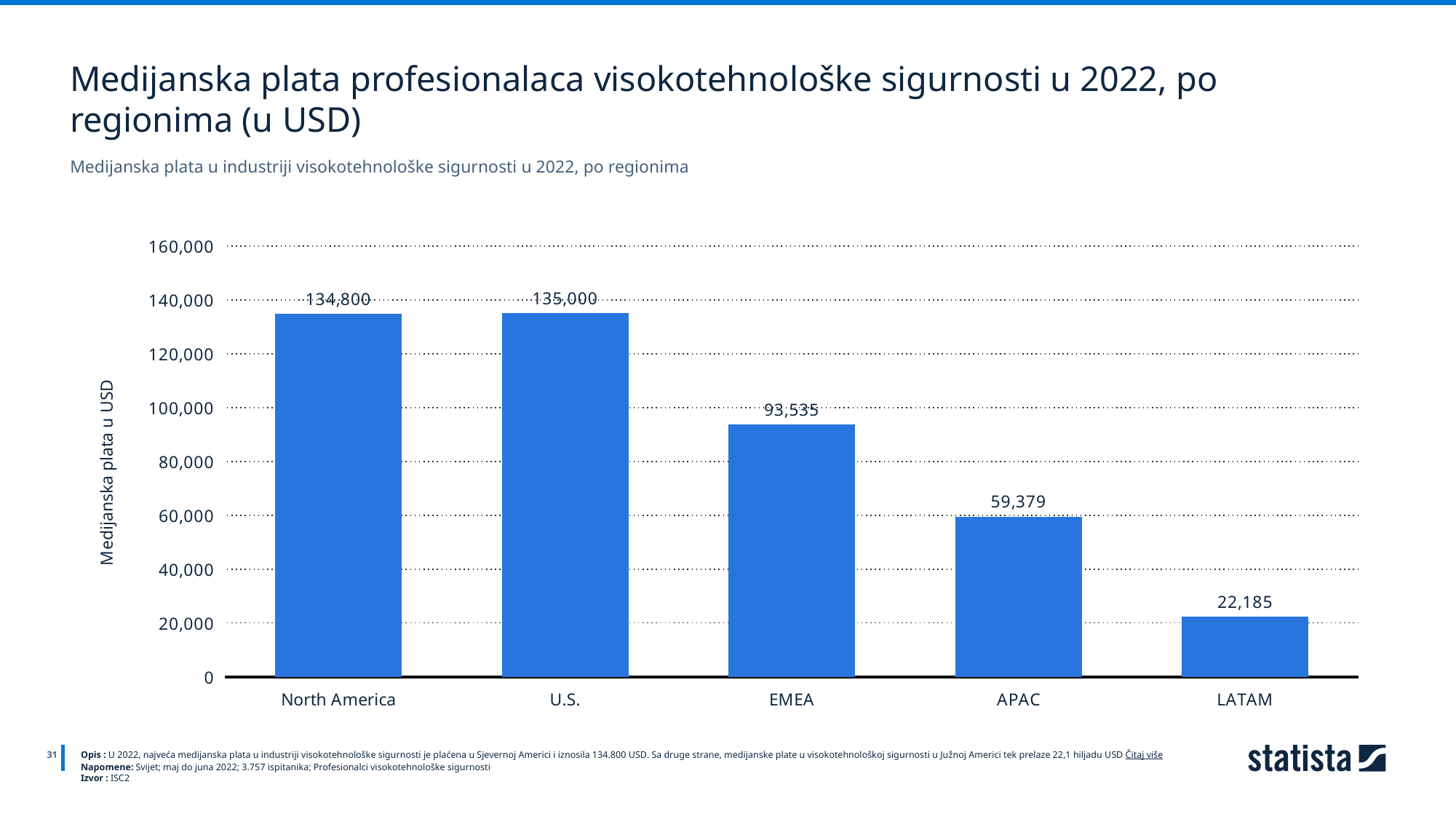
Which is larger, the value for EMEA or the value for APAC? EMEA What kind of chart is shown on the slide? bar chart What is the value shown for LATAM? 22,185 How many regions are shown on the chart? 5 Which region has the highest median salary according to the data labels? U.S. What is the difference between the values for U.S. and North America? 200 What is the value shown for APAC? 59,379 What is the median salary shown for EMEA? 93,535 Is the value for LATAM greater or less than 20,000? greater What is the value shown for North America? 134,800 What is the difference between the values for EMEA and APAC? 34,156 Which region has the lowest median salary? LATAM